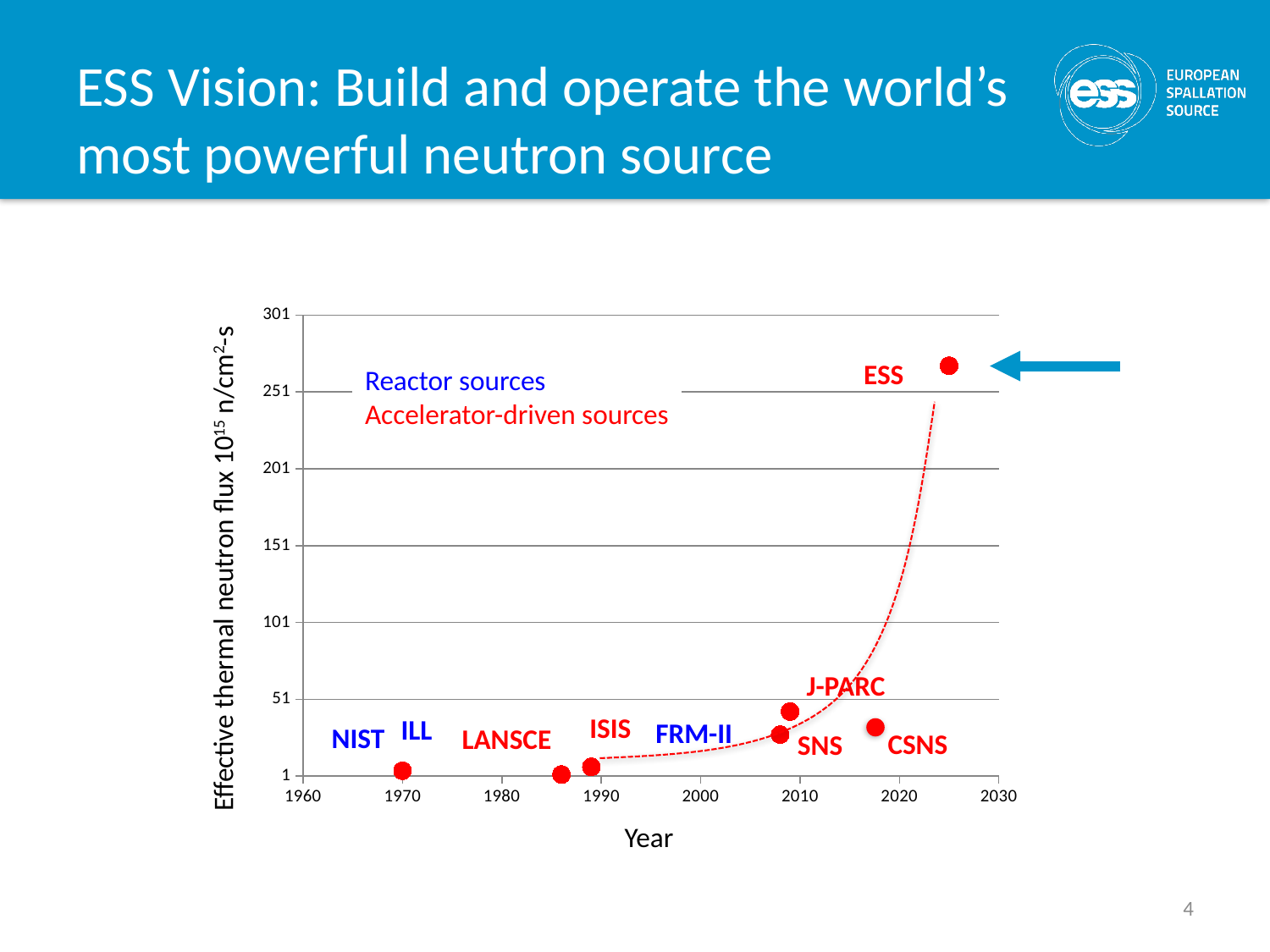
What kind of chart is shown on the slide? scatter chart Is the effective thermal neutron flux for J-PARC greater or less than 51? less Is the effective thermal neutron flux for ESS greater or less than 301? less According to the chart's legend, what colour is used for accelerator-driven sources? red Do the plotted flux values generally rise or fall as the year increases along the x axis? rise What is the title of the x axis? Year Which has the larger effective thermal neutron flux, ESS or J-PARC? ESS Which has the larger effective thermal neutron flux, J-PARC or SNS? J-PARC Is the effective thermal neutron flux for ESS greater or less than 251? greater Which neutron source has the highest effective thermal neutron flux on the chart? ESS Which source is plotted at the latest year on the chart? ESS How many neutron sources are labelled on the chart? 9